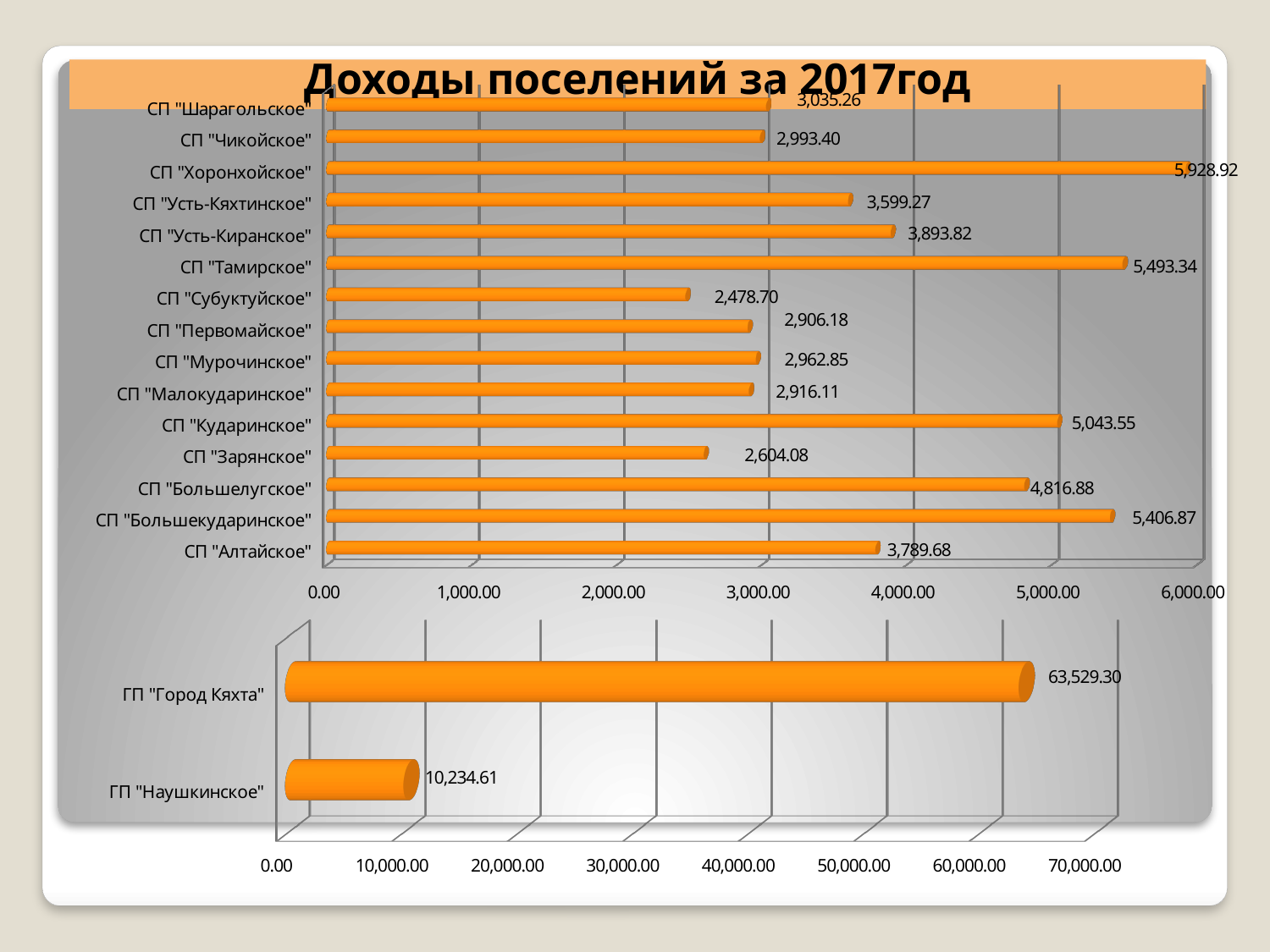
How many categories are shown in the bottom chart? 2 In the top chart, what is the difference between СП "Хоронхойское" and СП "Субуктуйское"? 3,450.22 In the top chart, is the value for СП "Большелугское" greater or less than 4,000.00? greater How many categories are shown in the top chart? 15 In the top chart, which category has the lowest value? СП "Субуктуйское" In the bottom chart, what is the difference between ГП "Город Кяхта" and ГП "Наушкинское"? 53,294.69 In the bottom chart, what is the value for ГП "Наушкинское"? 10,234.61 In the top chart, what is the value for СП "Зарянское"? 2,604.08 What type of chart is the bottom chart? Bar chart In the top chart, which is larger: СП "Тамирское" or СП "Кударинское"? СП "Тамирское" In the top chart, which category has the highest value? СП "Хоронхойское" In the top chart, what is the value for СП "Хоронхойское"? 5,928.92